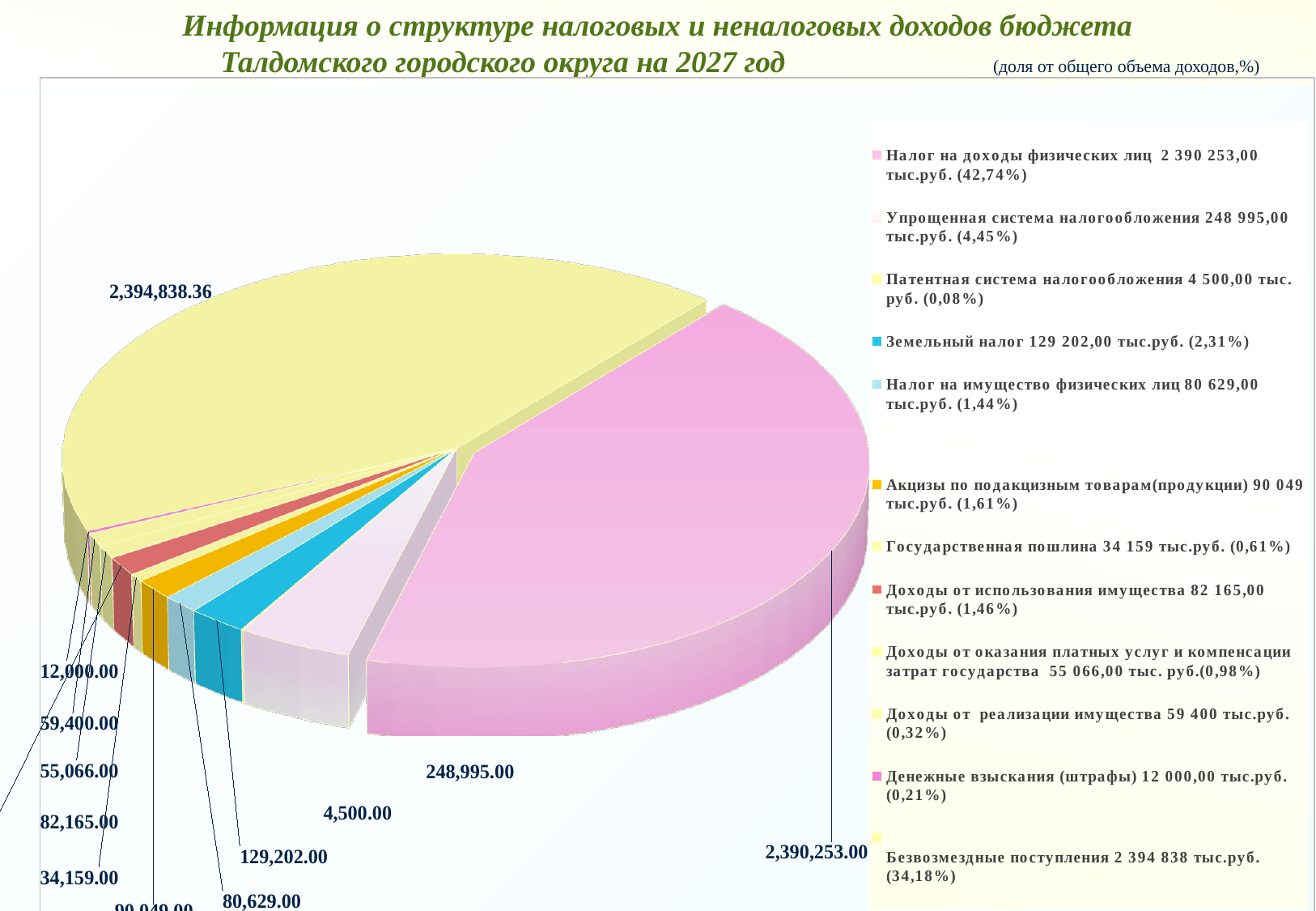
What is the difference between the values for Доходы от использования имущества and Доходы от оказания платных услуг и компенсации затрат государства? 27,099.00 Which is larger: Акцизы по подакцизным товарам(продукции) or Доходы от использования имущества? Акцизы по подакцизным товарам(продукции) What percentage share does the legend give for Налог на доходы физических лиц? 42,74% What value is shown on the chart for Упрощенная система налогообложения? 248,995.00 What value is shown on the chart for Земельный налог? 129,202.00 What value is shown on the chart for Денежные взыскания (штрафы)? 12,000.00 How many categories (slices) does the pie chart have? 12 What is the difference between the values for Земельный налог and Налог на имущество физических лиц? 48,573.00 What kind of chart is shown on the slide? pie chart Which is larger: Земельный налог or Налог на имущество физических лиц? Земельный налог Which category has the smallest slice in the pie chart? Патентная система налогообложения What value is shown on the chart for Безвозмездные поступления? 2,394,838.36